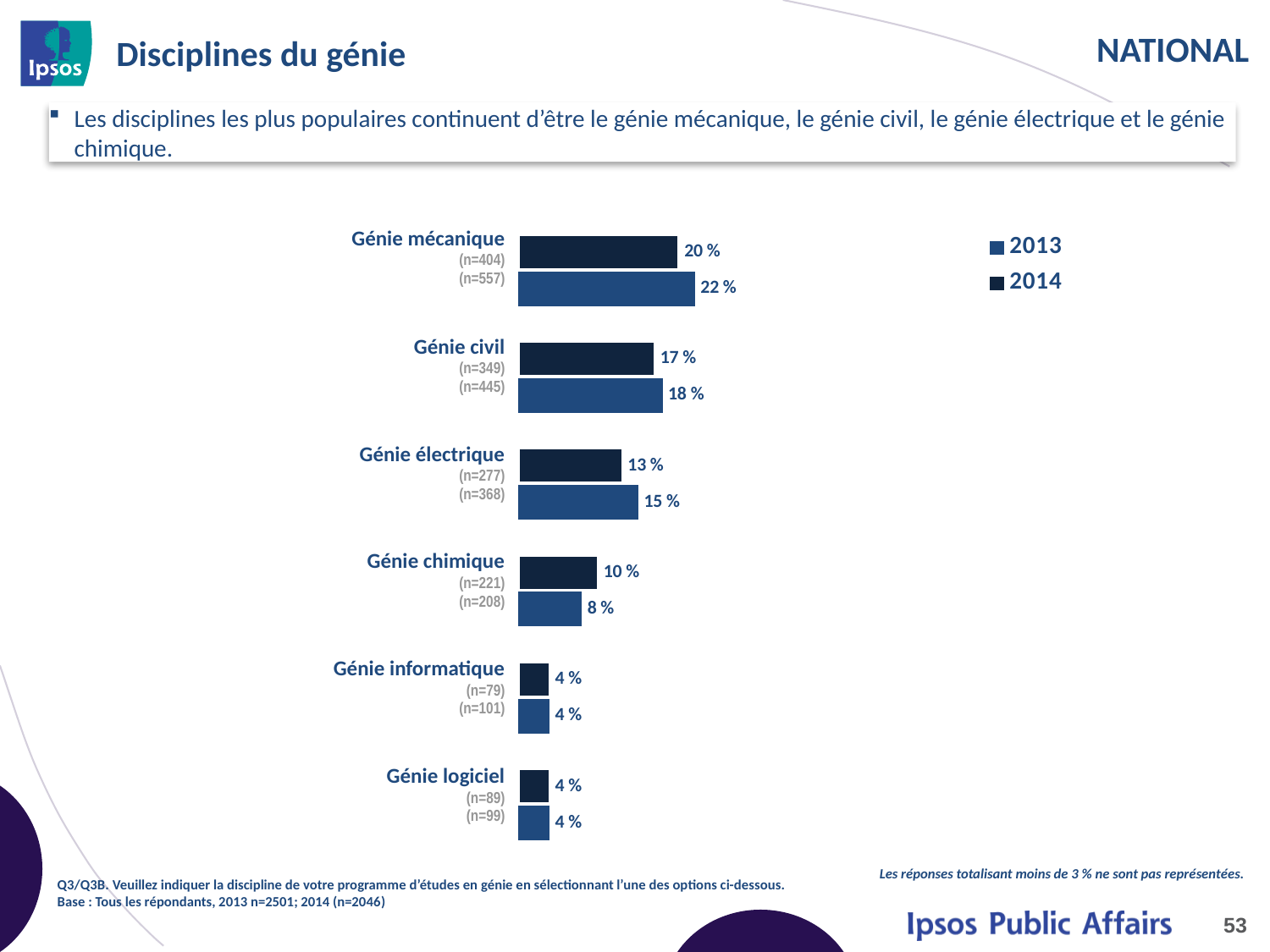
What is the difference between the 2014 values for Génie mécanique and Génie civil? 3 % Which years are listed in the chart legend? 2013 and 2014 What is the 2013 value for Génie électrique? 15 % How many series does the legend list? 2 What kind of chart is shown on the slide? bar chart For Génie chimique, which year has the larger value, 2013 or 2014? 2014 What is the 2014 value for Génie chimique? 10 % What is the difference between the 2013 and 2014 values for Génie électrique? 2 % What is the 2013 value for Génie mécanique? 22 % What is the 2014 value for Génie mécanique? 20 % How many engineering disciplines are shown in the chart? 6 Which discipline has the highest 2014 value? Génie mécanique